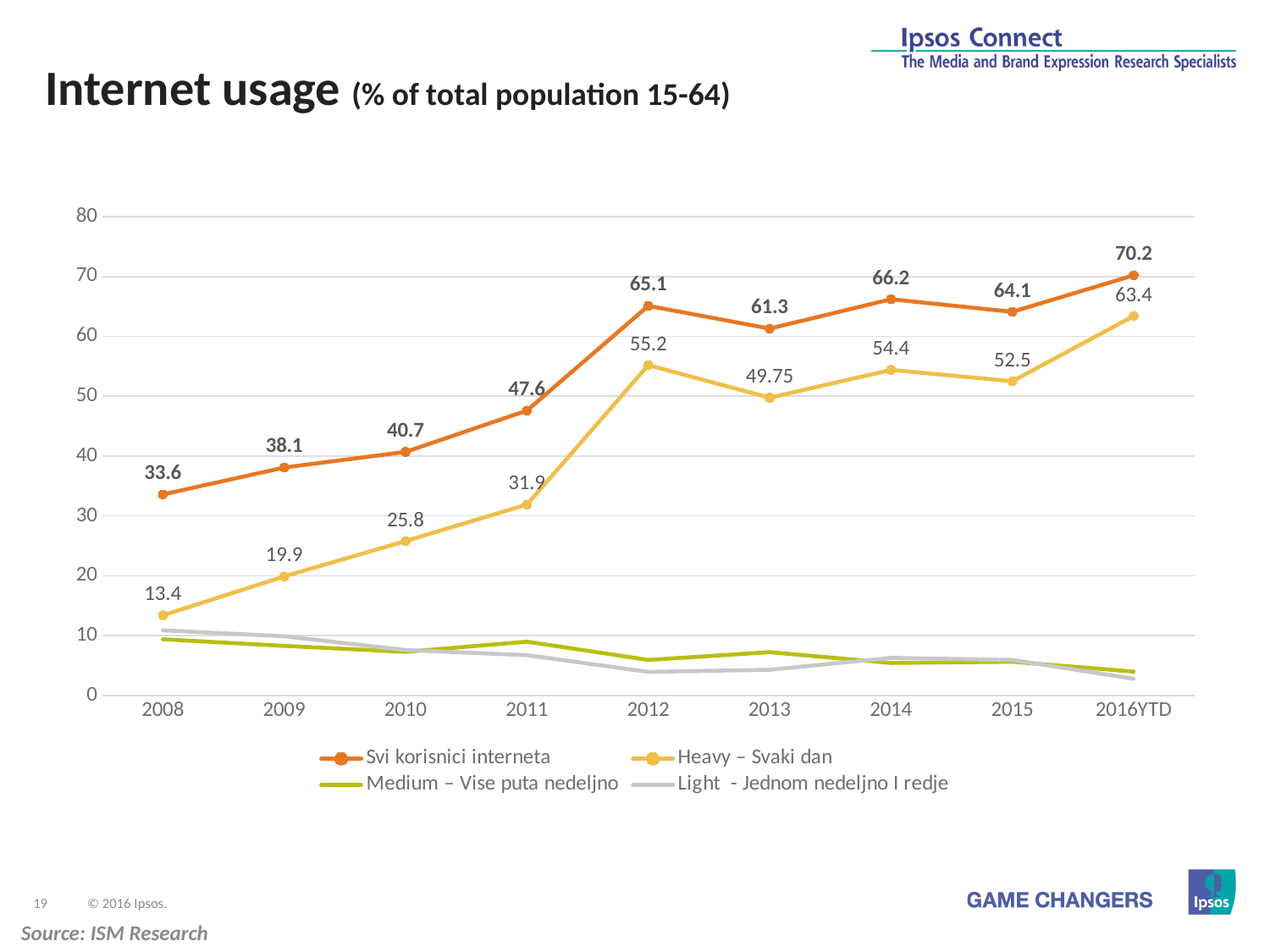
What is the value for Svi korisnici interneta in 2016YTD? 70.2 What kind of chart is shown on the slide? line chart What is the difference between Svi korisnici interneta and Heavy – Svaki dan in 2012? 9.9 Is the value for Light - Jednom nedeljno I redje in 2008 greater or less than 20? less Which is larger in 2011: Svi korisnici interneta or Heavy – Svaki dan? Svi korisnici interneta In which year is the Svi korisnici interneta series highest? 2016YTD What is the value for Svi korisnici interneta in 2008? 33.6 Does the Heavy – Svaki dan series generally rise or fall from 2008 to 2016YTD? rise How many years are shown on the x axis? 9 In which year is the Heavy – Svaki dan series lowest? 2008 How many series does the legend list? 4 What is the value for Heavy – Svaki dan in 2013? 49.75